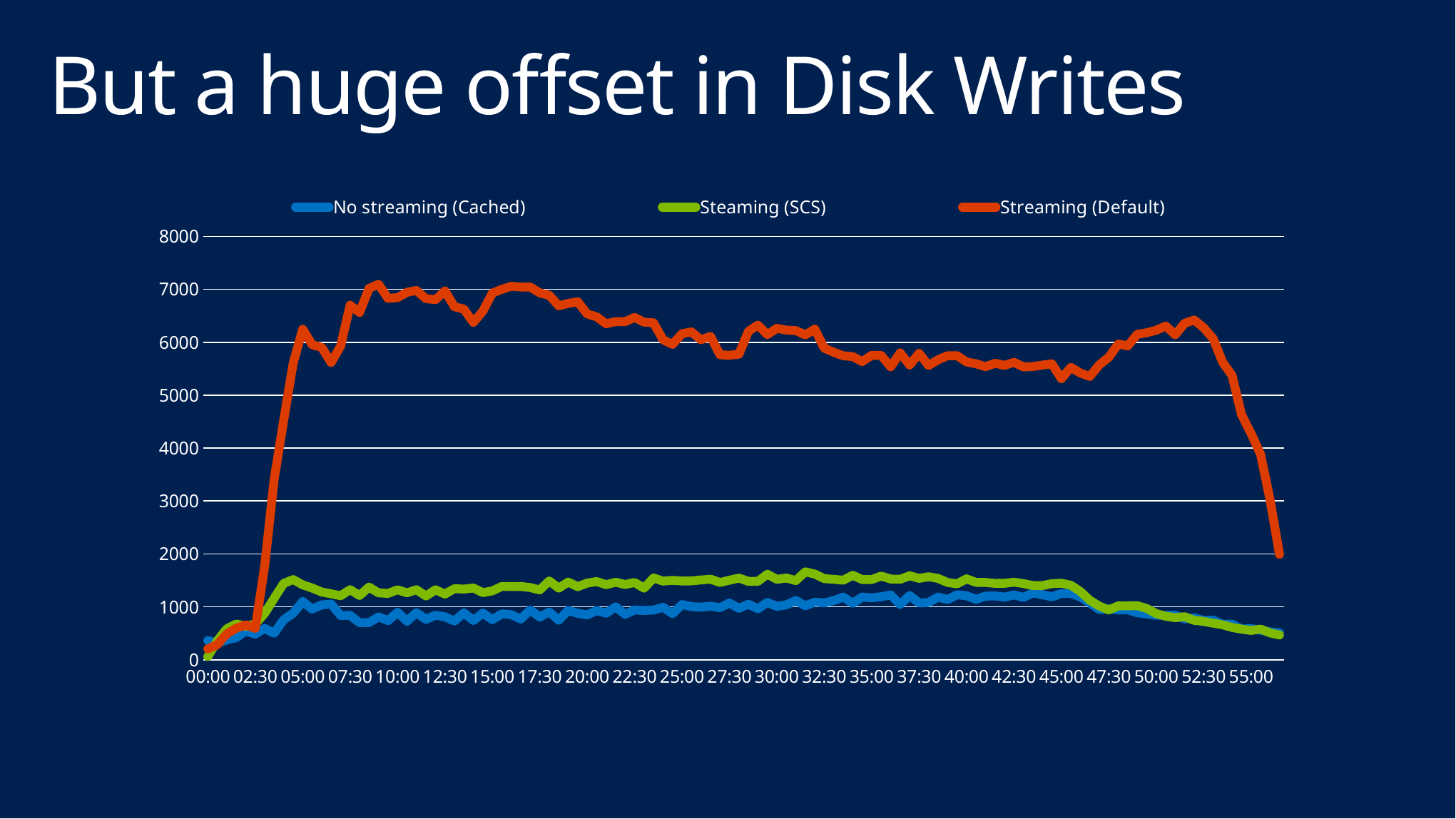
Which series has the lowest values across most of the chart? No streaming (Cached) Is the value for Steaming (SCS) at 30:00 greater or less than 2000? less What kind of chart is shown on the slide? line chart Is the value for No streaming (Cached) at 00:00 greater or less than 1000? less How many time labels are shown on the x axis? 23 Is the value for Streaming (Default) at 10:00 greater or less than 6000? greater Does the Streaming (Default) line rise or fall between 50:00 and 55:00? fall How many series does the legend list? 3 What is the title of the slide containing the chart? But a huge offset in Disk Writes Which series is drawn in orange-red in the chart? Streaming (Default) Which series has the highest values across most of the chart? Streaming (Default) At 30:00, which is larger: Streaming (Default) or Steaming (SCS)? Streaming (Default)